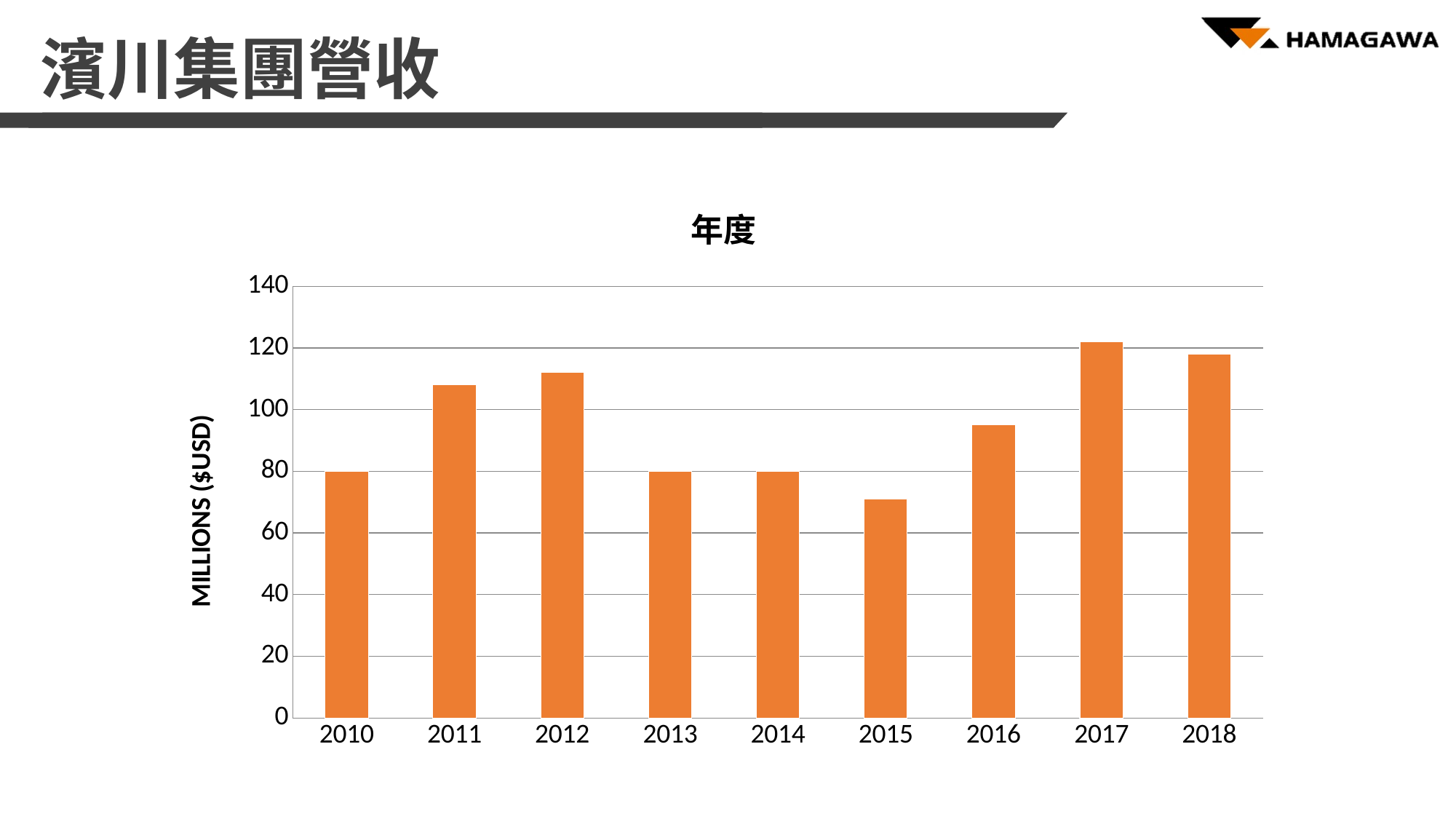
Do the values rise or fall from 2015 to 2017? rise Which year has the larger value, 2016 or 2017? 2017 What kind of chart is shown on the slide? bar chart Which year has the larger value, 2015 or 2016? 2016 Is the value for 2015 greater or less than 80? less What is the label on the vertical axis of the chart? MILLIONS ($USD) Is the value for 2011 greater or less than 100? greater Is the value for 2017 greater or less than 120? greater Which year has the highest value in the chart? 2017 Which year has the lowest value in the chart? 2015 How many years are shown on the x axis of the chart? 9